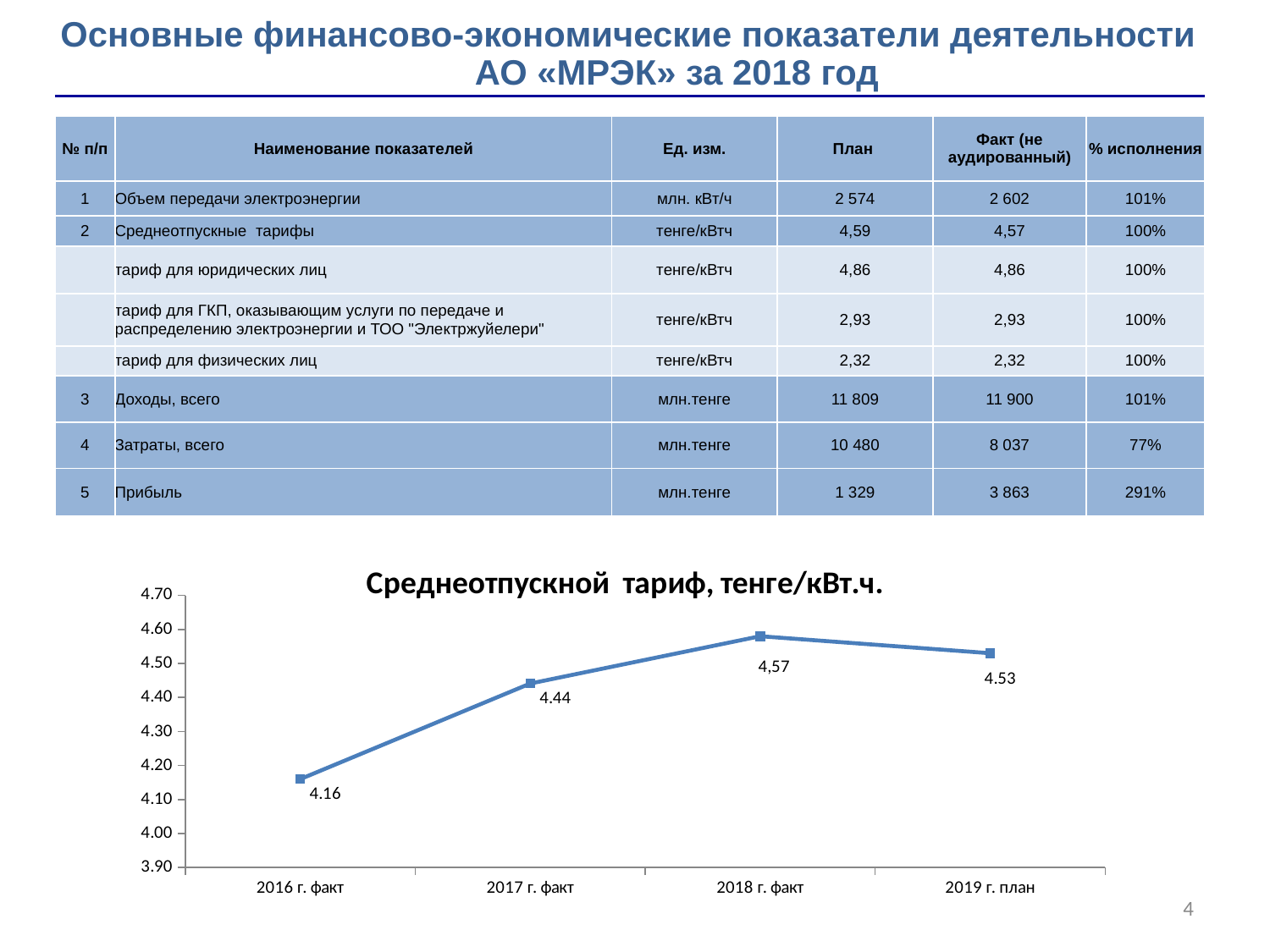
What type of chart is shown on the slide? line chart Which category has the lowest value in the chart? 2016 г. факт Which is larger, the value for 2018 г. факт or the value for 2019 г. план? 2018 г. факт What is the title of the chart? Среднеотпускной тариф, тенге/кВт.ч. Is the value for 2016 г. факт greater or less than 4.20? less Which category has the highest value in the chart? 2018 г. факт What is the difference between the values for 2017 г. факт and 2016 г. факт? 0.28 What is the value for 2016 г. факт in the chart? 4.16 What is the value for 2019 г. план in the chart? 4.53 What is the value for 2018 г. факт in the chart? 4,57 How many data points are plotted in the chart? 4 What is the value for 2017 г. факт in the chart? 4.44